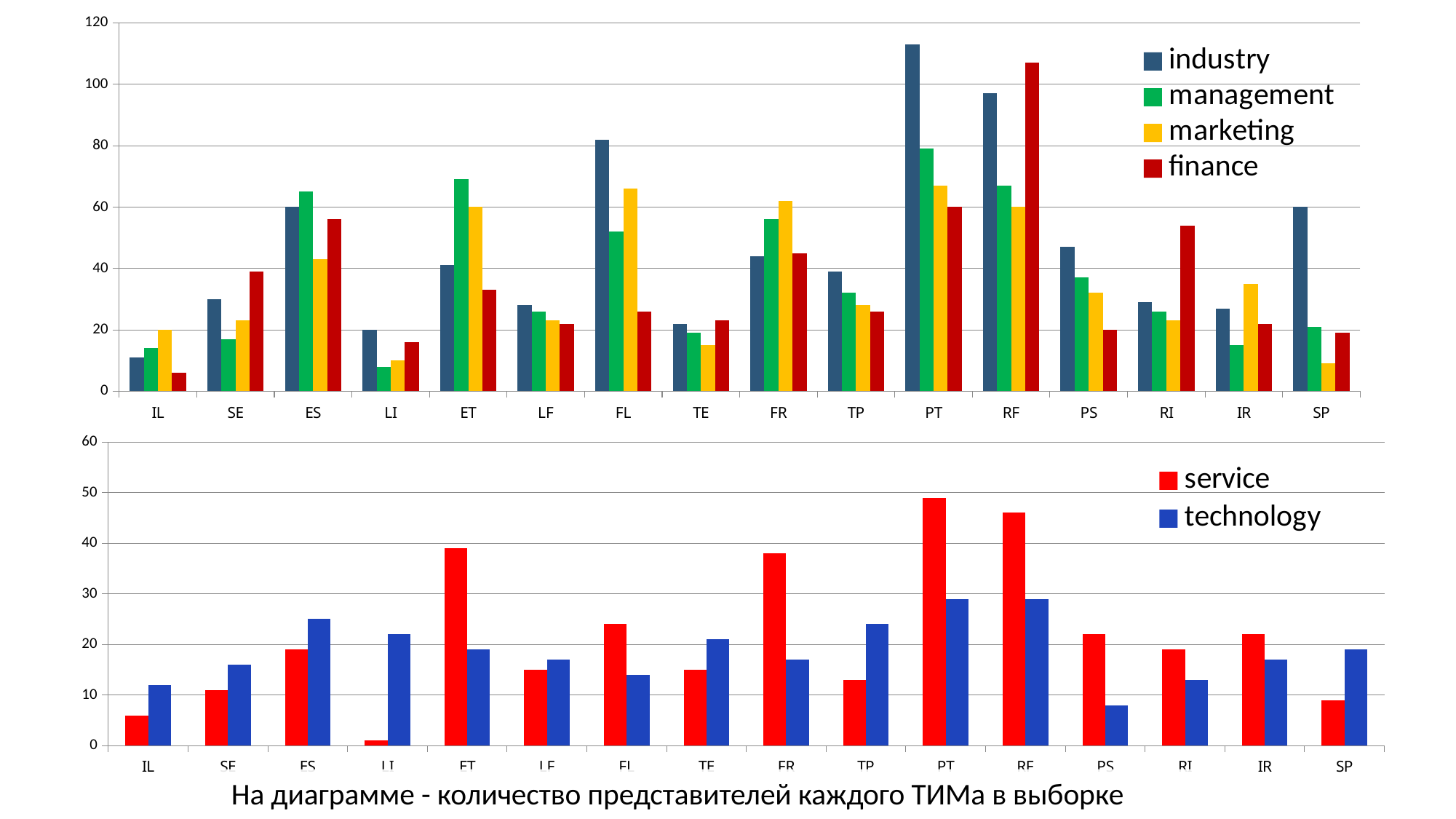
In the bottom chart, how many series does the legend list? 2 In the top chart, for ES, which is larger: management or marketing? management In the top chart, which category has the highest industry value? PT In the bottom chart, for LI, which is larger: service or technology? technology In the bottom chart, which category has the highest service value? PT In the bottom chart, which category has the lowest service value? LI In the bottom chart, is the service value for ET greater or less than 30? greater In the top chart, how many series does the legend list? 4 In the top chart, is the industry value for PT greater or less than 100? greater In the top chart, is the finance value for RF greater or less than 100? greater What kind of chart is the bottom chart? bar chart In the top chart, how many categories are shown on the x axis? 16